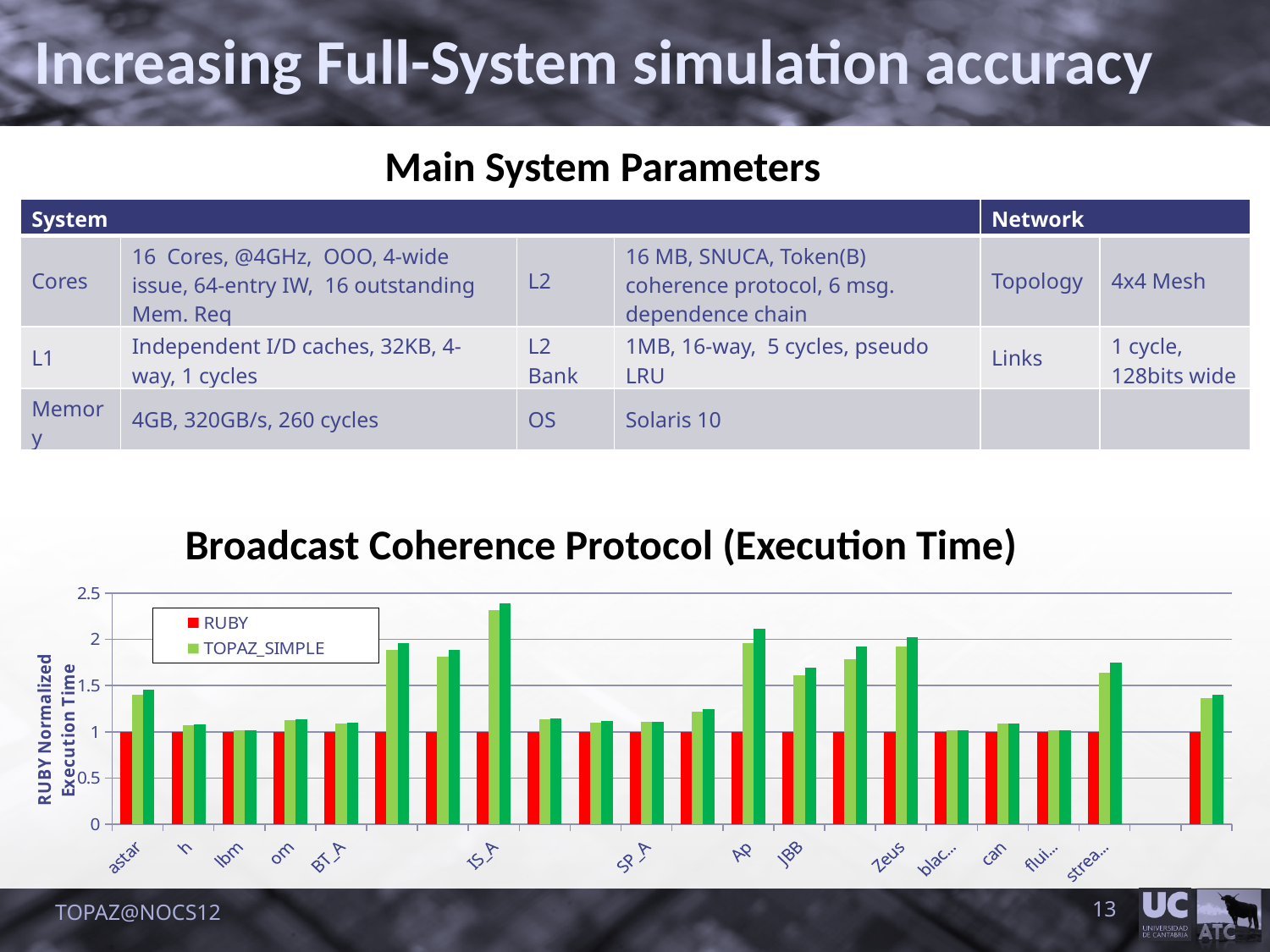
What is the RUBY value for astar in the chart? 1 What is the label of the vertical axis of the chart? RUBY Normalized Execution Time Is the TOPAZ_SIMPLE value for JBB greater or less than 1.5? greater Is the TOPAZ_SIMPLE value for lbm greater or less than 1.5? less Is the TOPAZ_SIMPLE value for IS_A greater or less than 2? greater What kind of chart is shown under the heading 'Broadcast Coherence Protocol (Execution Time)'? bar chart What is the title of the chart on the slide? Broadcast Coherence Protocol (Execution Time) Which has the larger TOPAZ_SIMPLE value, JBB or lbm? JBB Which category has the highest TOPAZ_SIMPLE value in the chart? IS_A Which has the larger TOPAZ_SIMPLE value, IS_A or astar? IS_A How many series does the legend of the Broadcast Coherence Protocol chart list? 2